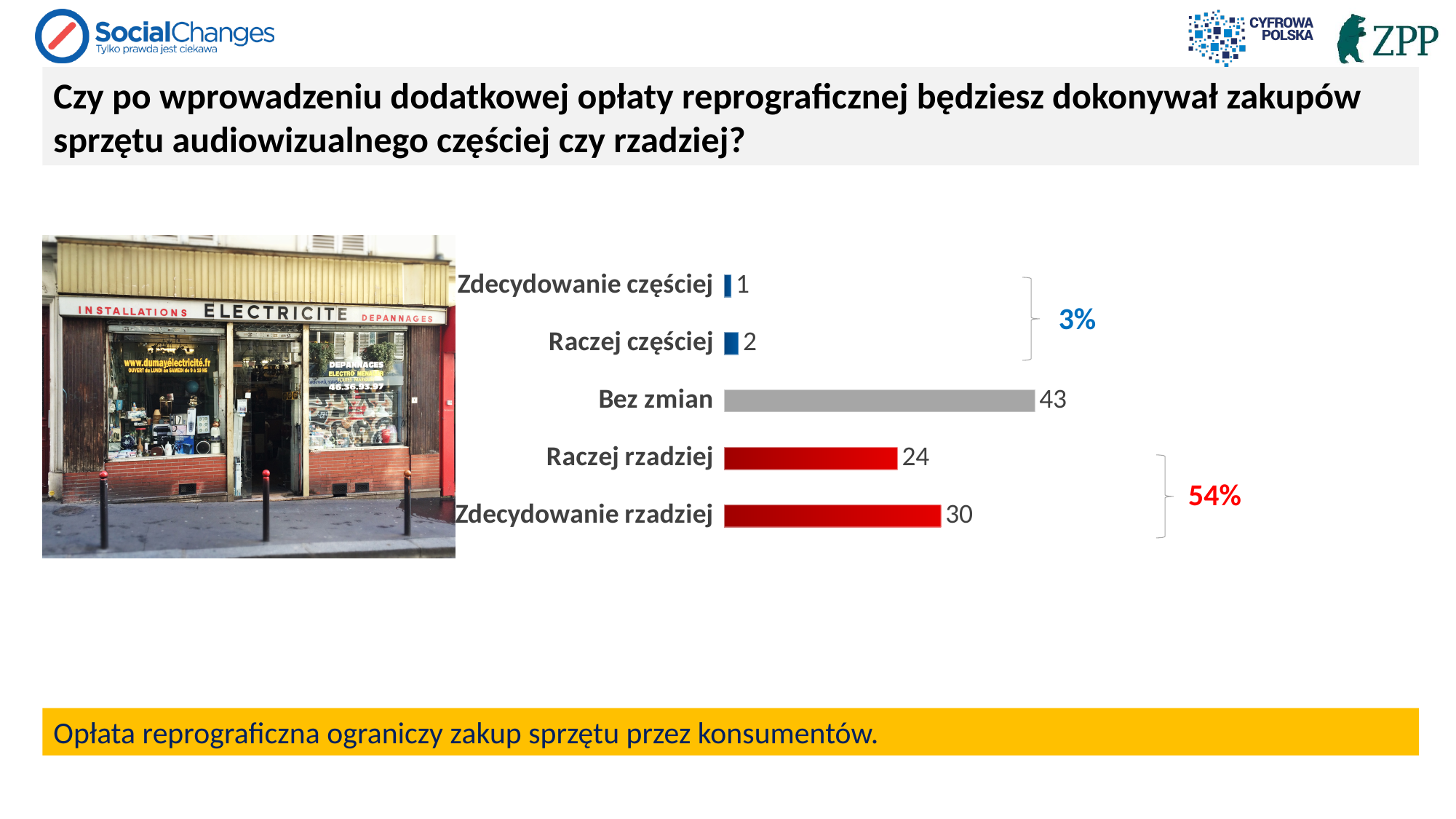
What is the difference between the values for "Bez zmian" and "Zdecydowanie rzadziej"? 13 What combined percentage is shown next to the bracket grouping "Zdecydowanie częściej" and "Raczej częściej"? 3% What is the value for "Raczej częściej"? 2 What is the value for "Zdecydowanie częściej"? 1 What is the value for "Zdecydowanie rzadziej"? 30 Which category has the highest value? Bez zmian Which is larger, the value for "Raczej rzadziej" or the value for "Zdecydowanie rzadziej"? Zdecydowanie rzadziej What kind of chart is shown on the slide? Bar chart What combined percentage is shown next to the bracket grouping "Raczej rzadziej" and "Zdecydowanie rzadziej"? 54% Which category has the lowest value? Zdecydowanie częściej How many categories are shown in the chart? 5 What is the value for "Bez zmian"? 43